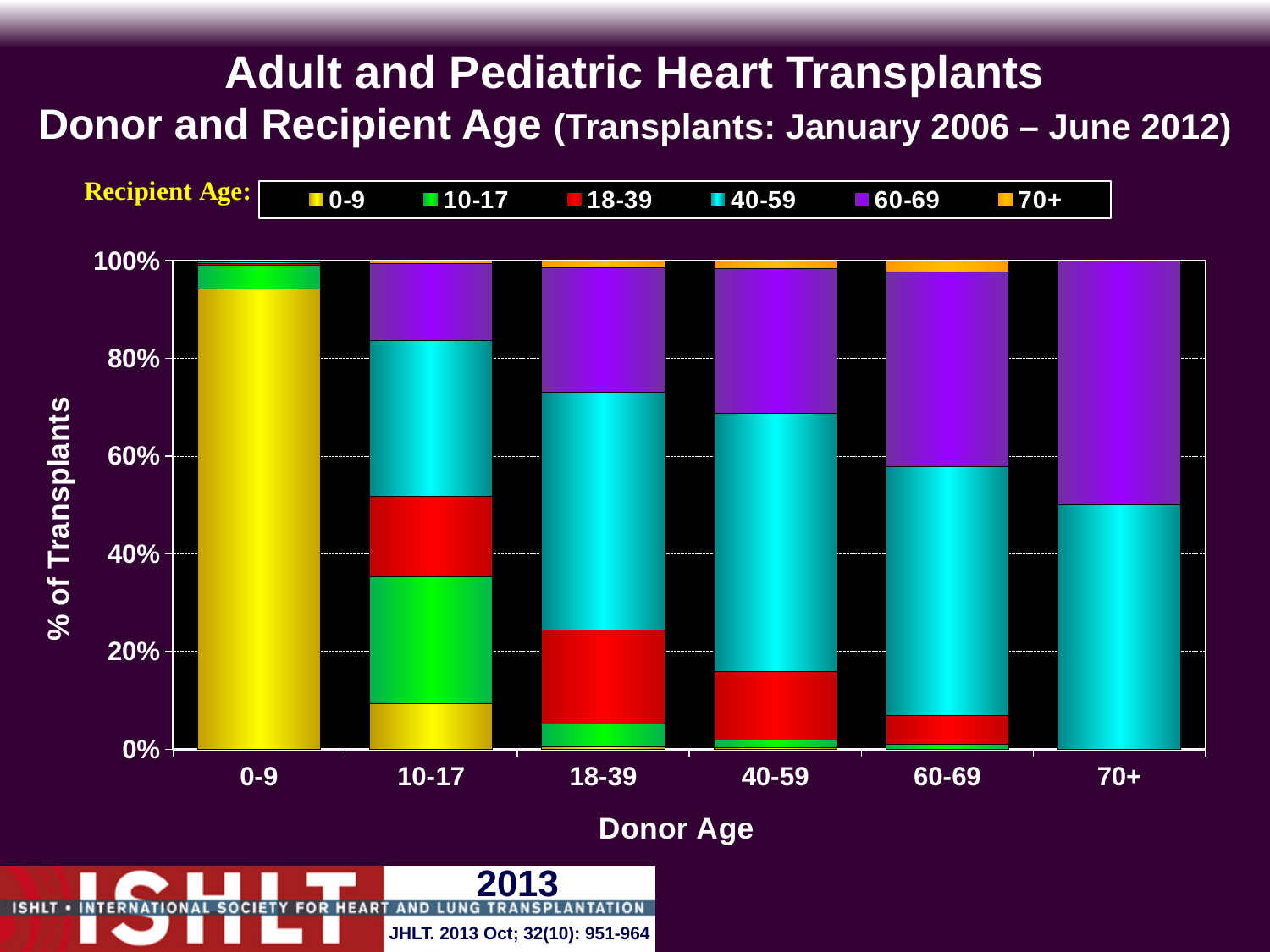
Which donor age group has the largest share of recipients aged 60-69? 70+ How many recipient age groups does the legend list? 6 For donor age 10-17, which is larger: the share of recipients aged 40-59 or the share of recipients aged 18-39? 40-59 Does the share of recipients aged 60-69 rise or fall as donor age increases along the x axis? Rises What is the label of the y axis? % of Transplants How many donor age categories are shown on the x axis? 6 What is the total height of the stacked bar for donor age 70+? 100% Which donor age group has the largest share of recipients aged 10-17? 10-17 Which donor age group has the largest share of recipients aged 0-9? 0-9 Is the share of recipients aged 0-9 for donor age 0-9 greater or less than 80%? greater Is the share of recipients aged 60-69 for donor age 60-69 greater or less than 20%? greater What kind of chart is shown on the slide? Stacked bar chart